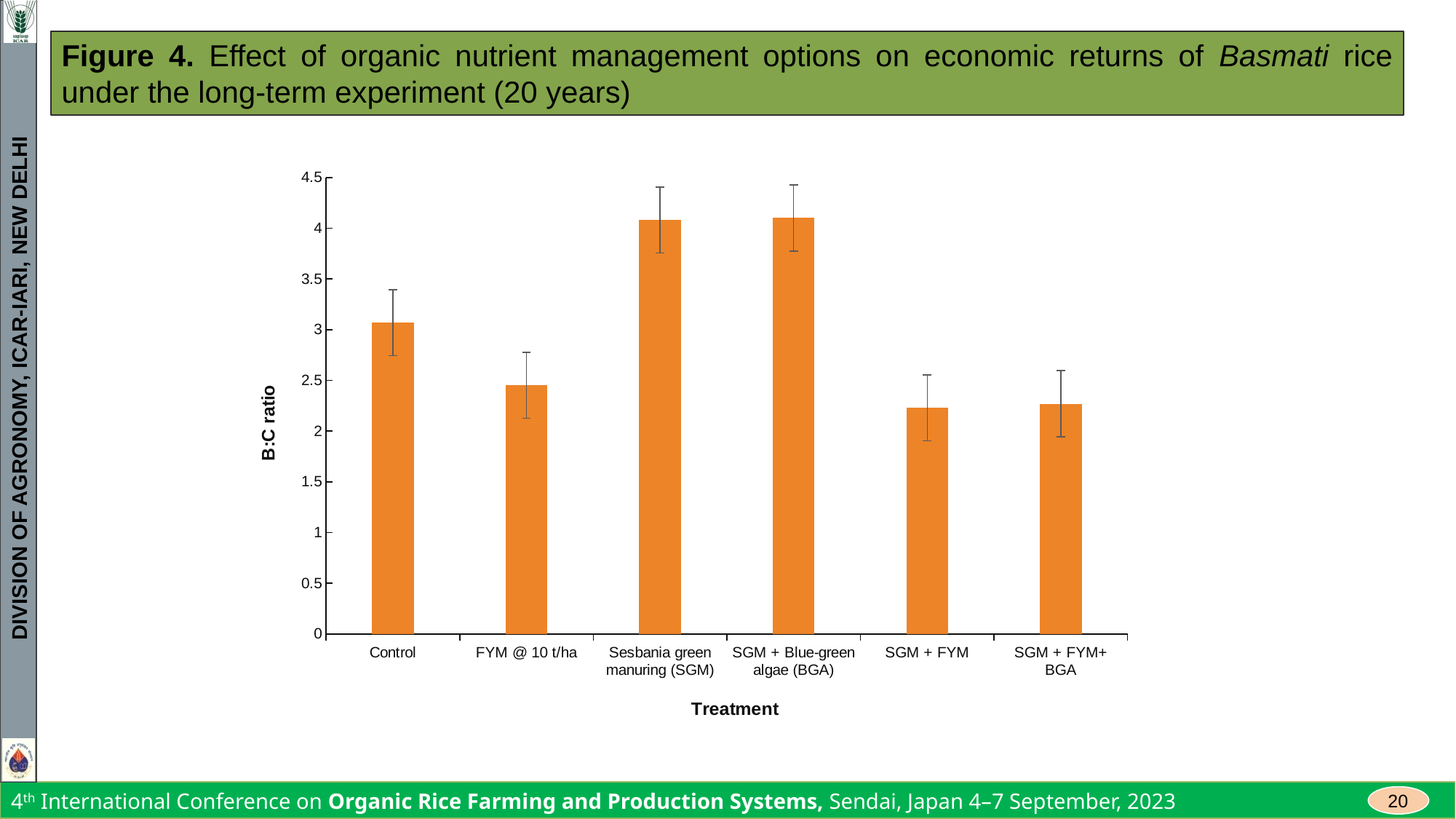
How many treatments are plotted on the x axis of the chart? 6 Is the B:C ratio for Sesbania green manuring (SGM) greater or less than 4? greater Which has the higher B:C ratio, Control or FYM @ 10 t/ha? Control Is the B:C ratio for SGM + Blue-green algae (BGA) greater or less than 3.5? greater What is the label of the x axis of the chart? Treatment What is the label of the y axis of the chart? B:C ratio Is the B:C ratio for SGM + FYM greater or less than 2.5? less Which has the higher B:C ratio, SGM + Blue-green algae (BGA) or SGM + FYM? SGM + Blue-green algae (BGA) What kind of chart is shown on the slide? bar chart